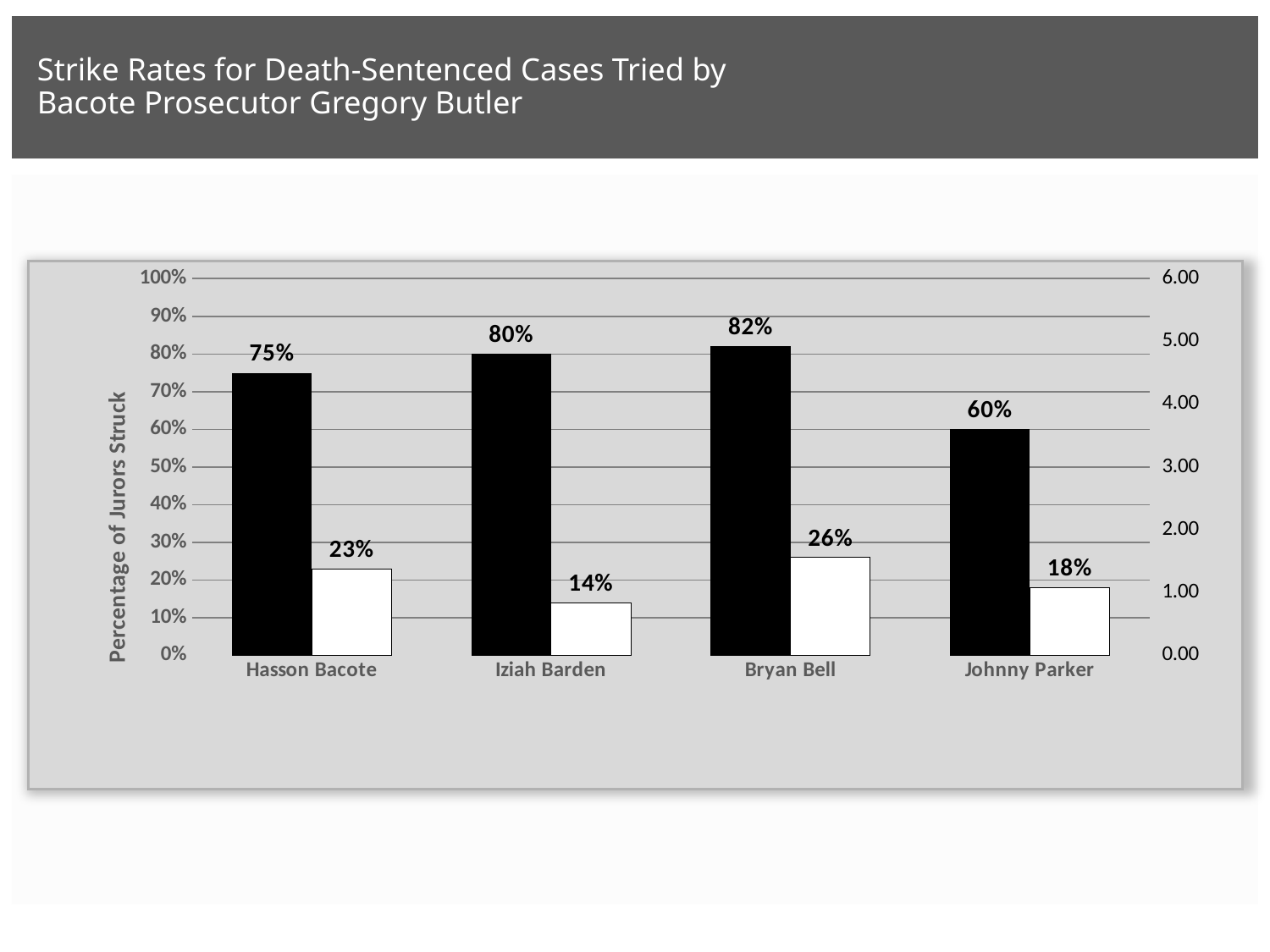
What kind of chart is shown on the slide? Bar chart What is the value of the white bar for Iziah Barden? 14% What is the value of the black bar for Hasson Bacote? 75% What is the difference between the black bar and the white bar for Hasson Bacote? 52% How many categories are shown on the x axis? 4 What is the value of the white bar for Bryan Bell? 26% Which category has the lowest white bar? Iziah Barden Which category has the highest black bar? Bryan Bell Which is larger, the white bar for Hasson Bacote or the white bar for Johnny Parker? Hasson Bacote What is the label of the left vertical axis? Percentage of Jurors Struck What is the value of the black bar for Johnny Parker? 60% What is the difference between the black bars for Bryan Bell and Johnny Parker? 22%